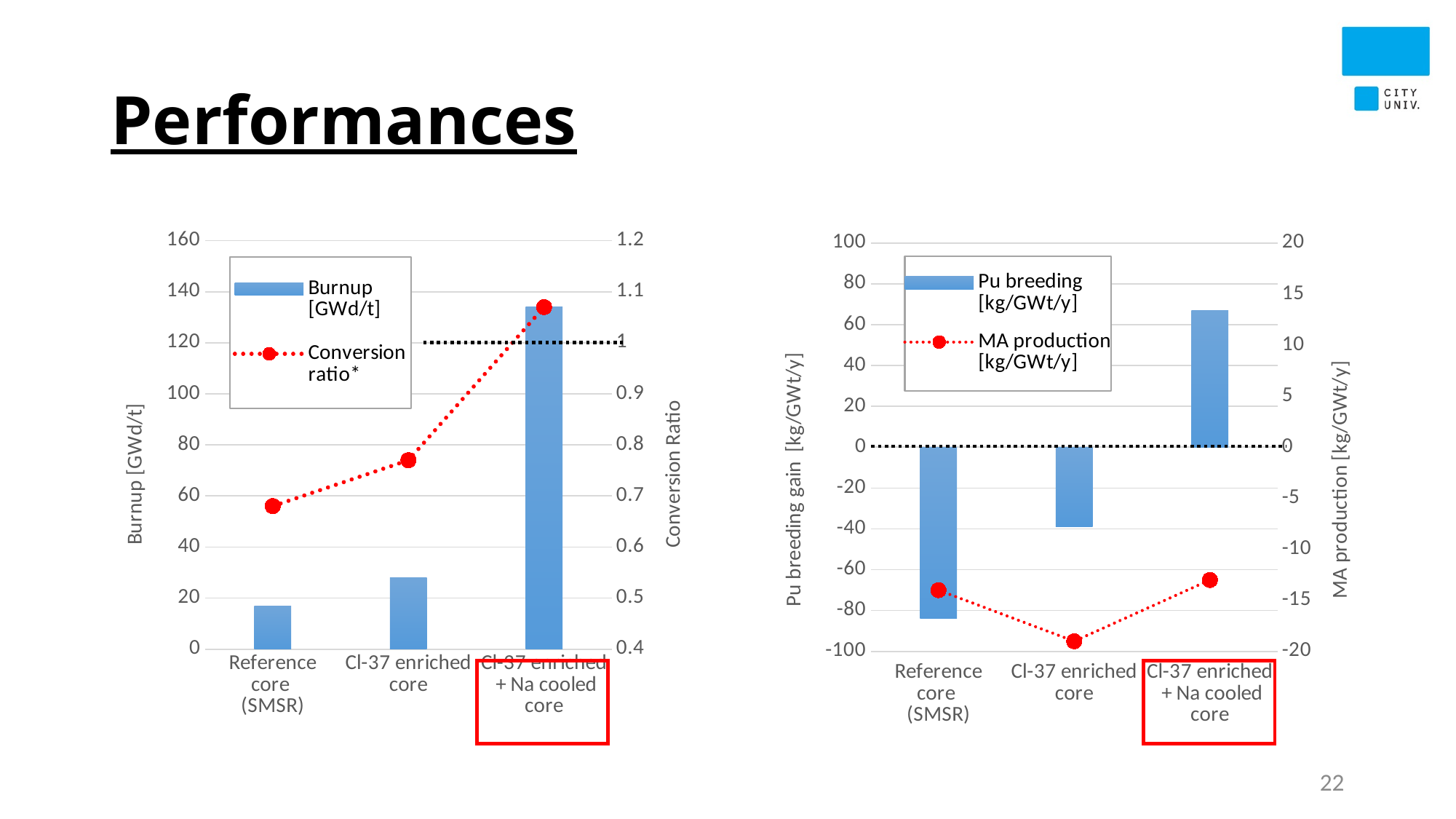
On the right chart, which category has the highest Pu breeding [kg/GWt/y]? Cl-37 enriched + Na cooled core On the left chart, which category has the lowest Burnup [GWd/t]? Reference core (SMSR) On the left chart, is the Conversion ratio for the Cl-37 enriched + Na cooled core greater or less than 1? greater On the left chart, is the Burnup value for the Cl-37 enriched + Na cooled core greater or less than 120? greater On the right chart, is the Pu breeding value for the Cl-37 enriched core greater or less than -20? less How many series does the legend of the left chart list? 2 On the left chart, does the Conversion ratio rise or fall from the Reference core (SMSR) to the Cl-37 enriched + Na cooled core? rise How many categories are shown on the x axis of the right chart? 3 On the right chart, which category has the lowest Pu breeding [kg/GWt/y]? Reference core (SMSR) On the left chart, which category has the highest Burnup [GWd/t]? Cl-37 enriched + Na cooled core On the right chart, which category has the lowest MA production [kg/GWt/y]? Cl-37 enriched core